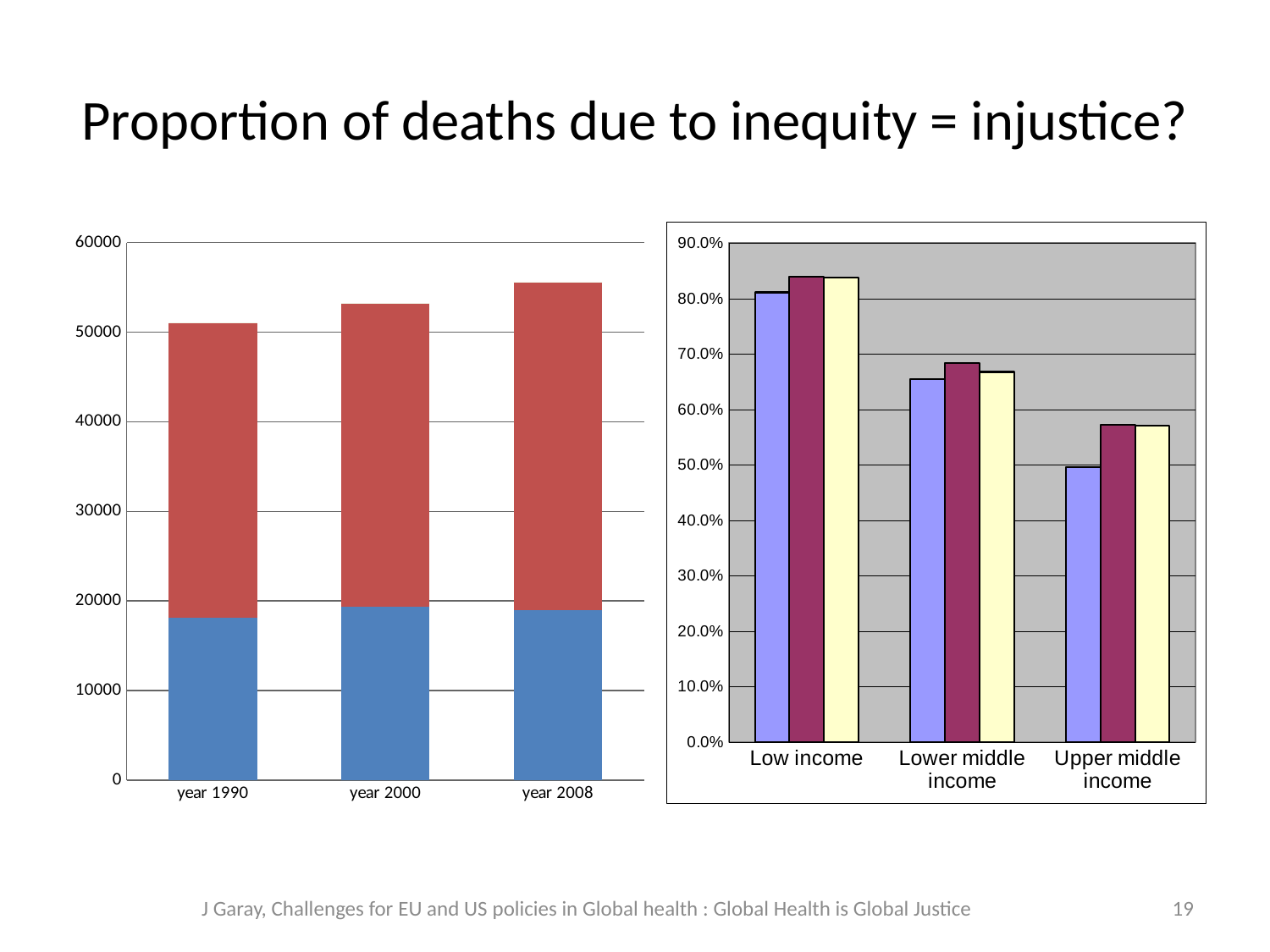
In the chart on the left, is the total height of the stacked bar for year 2008 greater or less than 60000? less In the chart on the left, how many years are shown on the x axis? 3 What kind of chart is the chart on the right of the slide? bar chart In the chart on the right, which income category has the lowest values? Upper middle income In the chart on the right, are the values for Low income greater or less than 70.0%? greater In the chart on the right, how many income categories are shown on the x axis? 3 In the chart on the left, do the total bar heights rise or fall from year 1990 to year 2008? rise In the chart on the right, which income category has the highest values? Low income In the chart on the right, do the values rise or fall from Low income to Upper middle income? fall What kind of chart is the chart on the left of the slide? bar chart In the chart on the left, is the blue segment for year 1990 greater or less than 20000? less